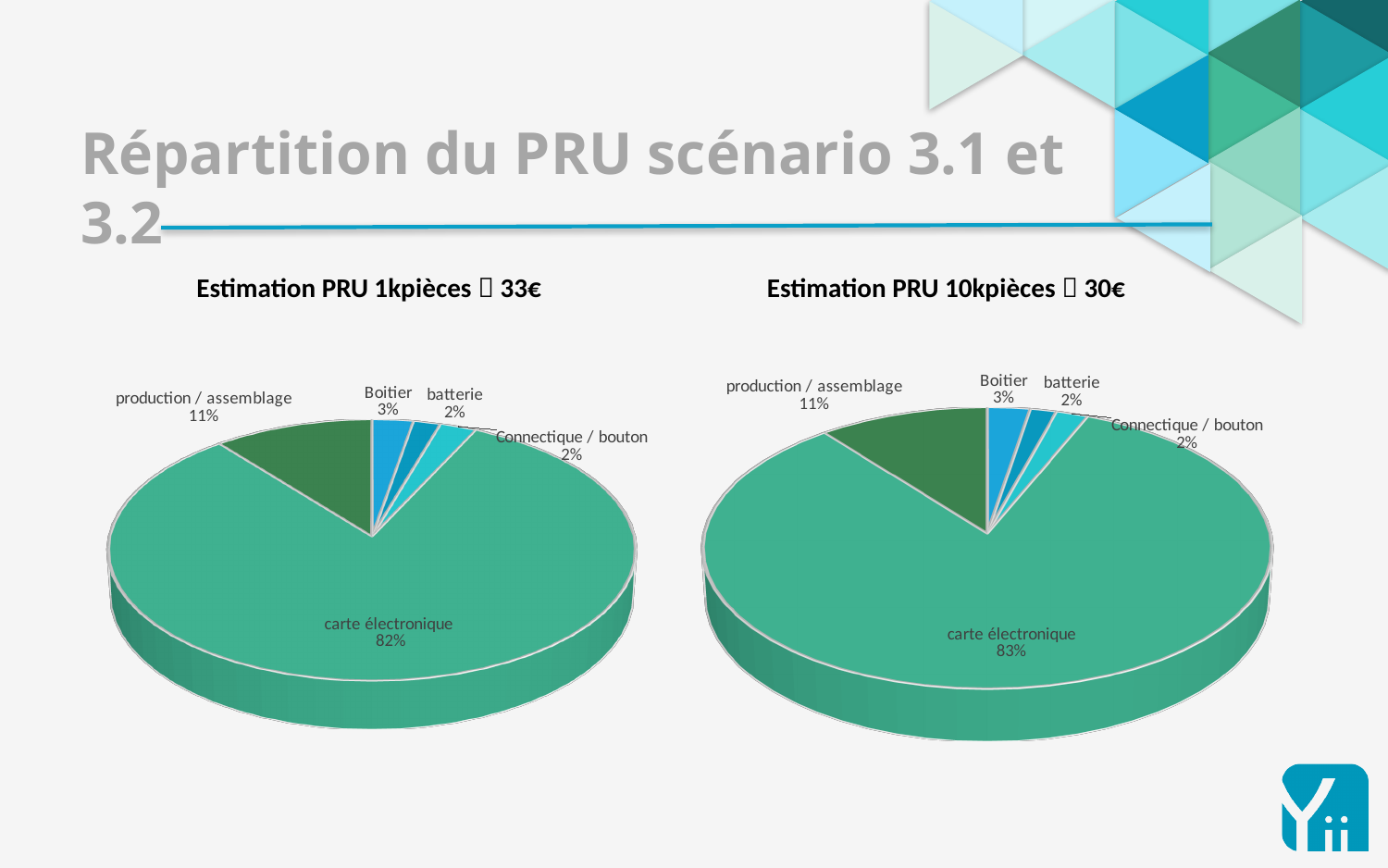
In the right chart (Estimation PRU 10kpièces), which category has the largest slice? carte électronique How many pie charts are shown on the slide? 2 In the right chart (Estimation PRU 10kpièces), which is larger, production / assemblage or Boitier? production / assemblage In the right chart (Estimation PRU 10kpièces), what is the value for Boitier? 3% In the left chart (Estimation PRU 1kpièces), which category has the largest slice? carte électronique What kind of chart is the left chart (Estimation PRU 1kpièces)? pie chart In the left chart (Estimation PRU 1kpièces), what is the value for batterie? 2% In the left chart (Estimation PRU 1kpièces), what is the value for production / assemblage? 11% In the right chart (Estimation PRU 10kpièces), what share does carte électronique have? 83% In the left chart (Estimation PRU 1kpièces), what share does carte électronique have? 82% How many slices does the left chart (Estimation PRU 1kpièces) have? 5 In the left chart (Estimation PRU 1kpièces), what is the difference between carte électronique and production / assemblage? 71%